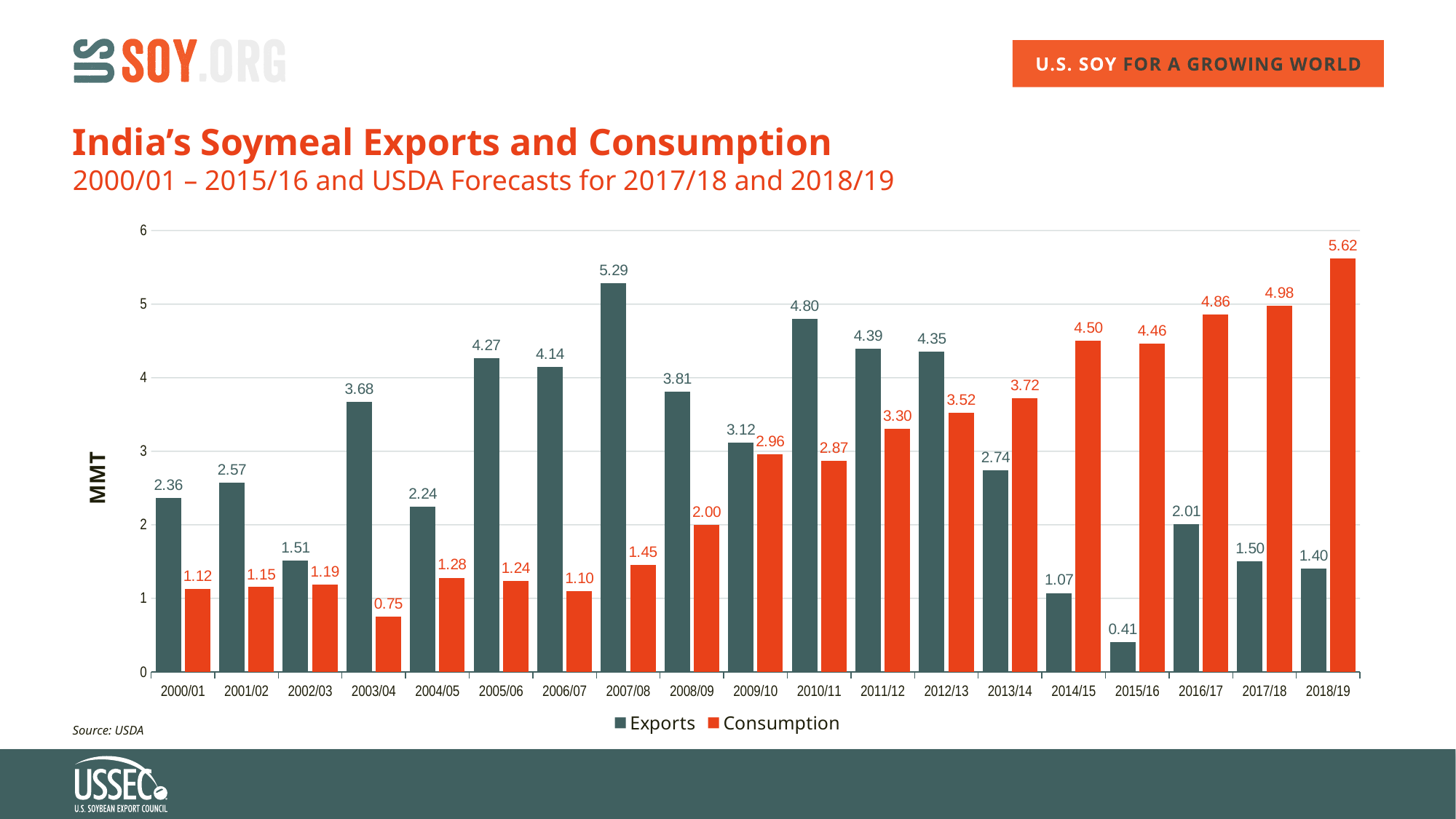
What was India's soymeal export value in 2007/08? 5.29 Which year has the highest Exports value? 2007/08 Which year has the lowest Consumption value? 2003/04 How many years are shown on the x axis? 19 What is the label on the vertical axis? MMT In 2009/10, which is larger, Exports or Consumption? Exports Is the Exports value for 2010/11 greater or less than 4? greater Which year has the lowest Exports value? 2015/16 What kind of chart is shown on the slide? Bar chart How many series does the legend list? 2 What is the forecast consumption value for 2018/19? 5.62 What is the difference between Consumption and Exports in 2018/19? 4.22